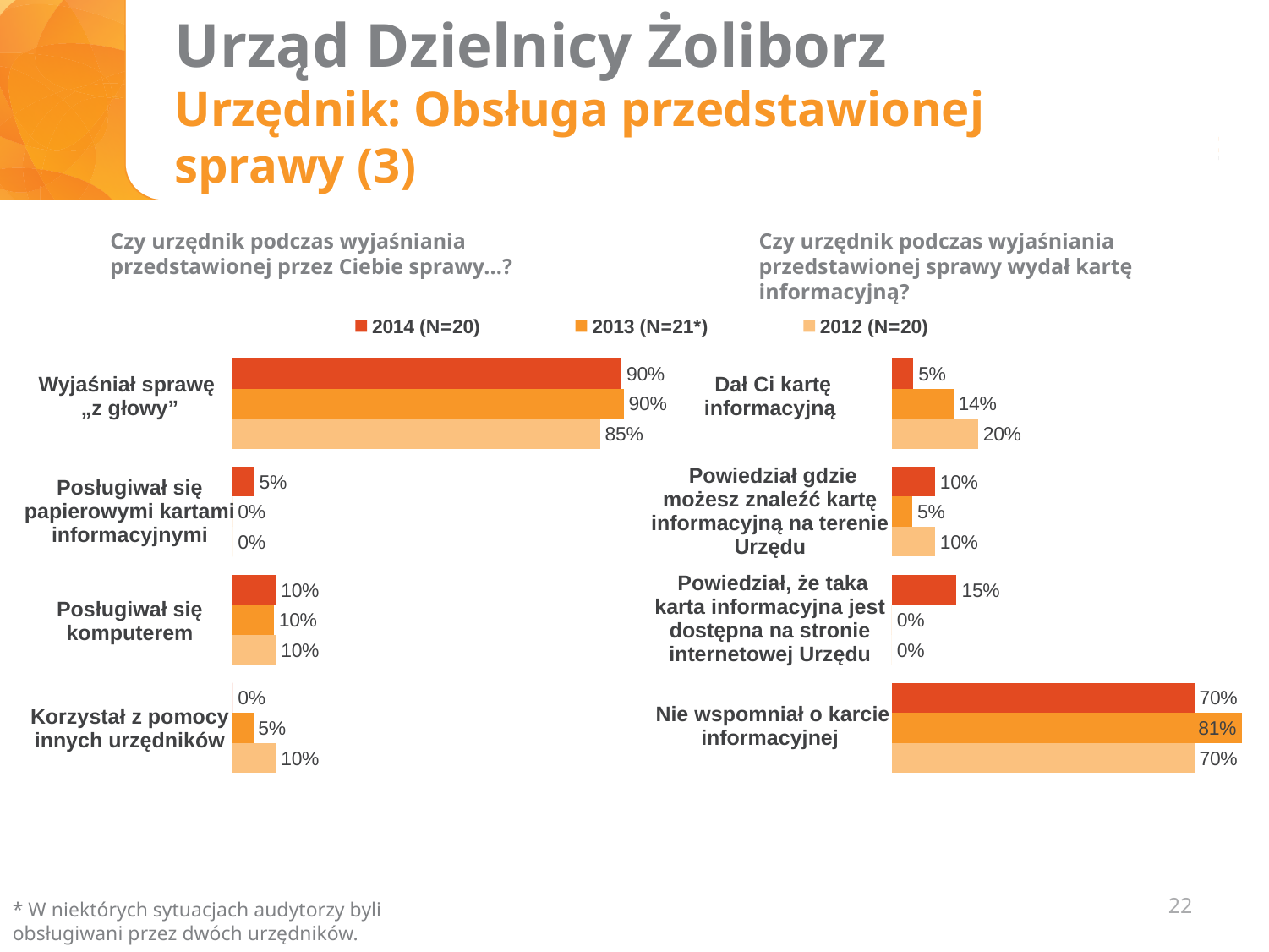
In the right chart, what is the difference between the 2013 (N=21*) and 2014 (N=20) values for "Nie wspomniał o karcie informacyjnej"? 11% In the left chart, what is the difference between the 2014 (N=20) and 2012 (N=20) values for "Wyjaśniał sprawę „z głowy”"? 5% In the left chart, what is the 2013 (N=21*) value for "Korzystał z pomocy innych urzędników"? 5% What kind of chart is the left chart? Bar chart In the right chart, what is the 2012 (N=20) value for "Dał Ci kartę informacyjną"? 20% In the right chart, which is larger for "Dał Ci kartę informacyjną": the 2014 (N=20) value or the 2012 (N=20) value? 2012 (N=20) In the left chart, what is the 2012 (N=20) value for "Wyjaśniał sprawę „z głowy”"? 85% In the right chart, what is the 2014 (N=20) value for "Powiedział, że taka karta informacyjna jest dostępna na stronie internetowej Urzędu"? 15% In the left chart, which category has the highest 2014 (N=20) value? Wyjaśniał sprawę „z głowy” How many series does the legend list? 3 In the left chart, what is the 2014 (N=20) value for "Wyjaśniał sprawę „z głowy”"? 90% In the right chart, what is the 2013 (N=21*) value for "Nie wspomniał o karcie informacyjnej"? 81%